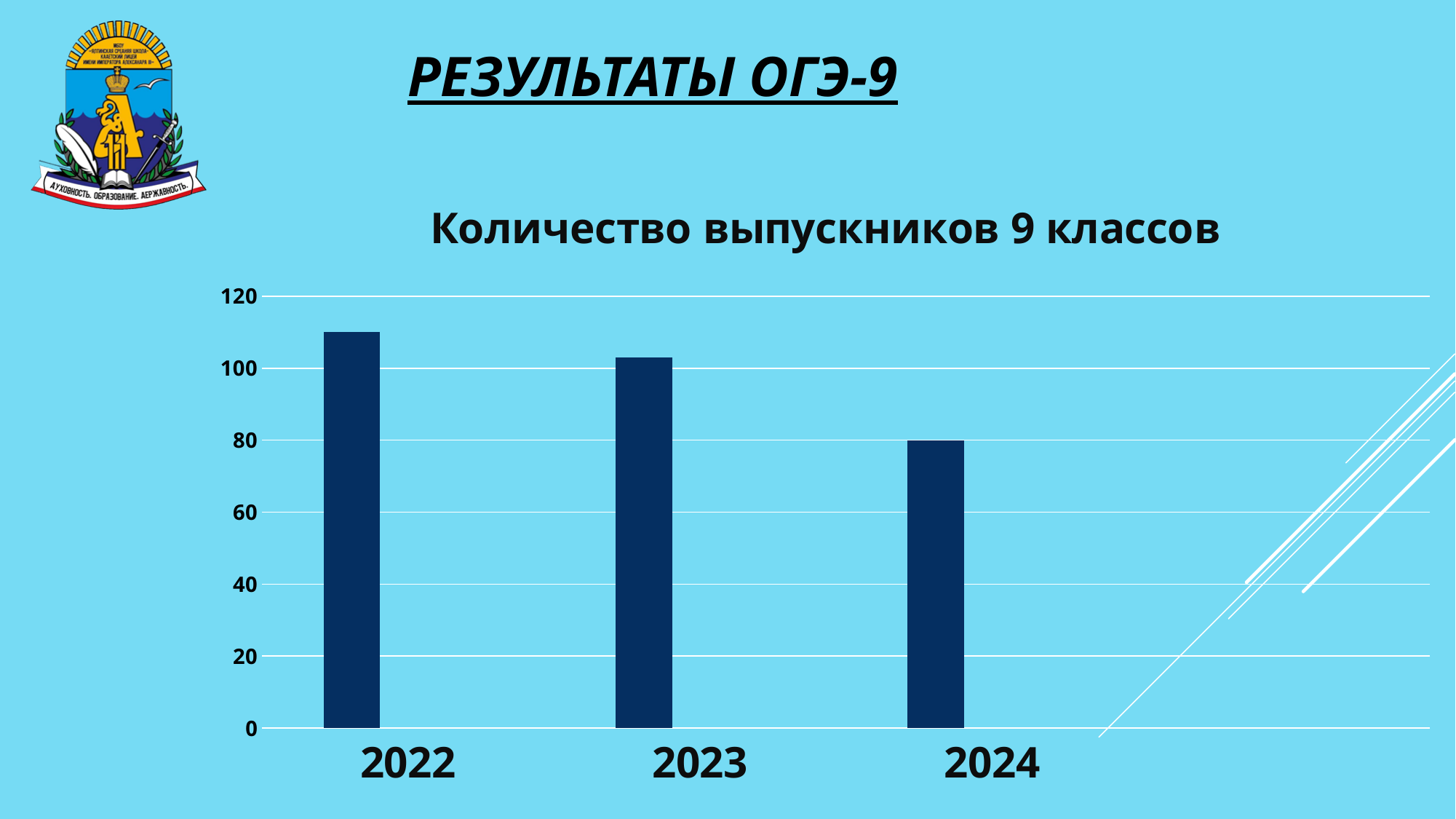
What is the title of the chart? Количество выпускников 9 классов How many years (categories) are shown on the x axis of the chart? 3 Which year has the highest number of 9th-grade graduates? 2022 What kind of chart is shown on the slide? bar chart Which year has the lowest number of 9th-grade graduates? 2024 Is the value for 2022 greater or less than 100? greater Do the values rise or fall from 2022 to 2024? fall Which year has more graduates, 2022 or 2024? 2022 Is the value for 2024 greater or less than 100? less Which year has more graduates, 2023 or 2024? 2023 Is the value for 2023 greater or less than 120? less What colour are the bars in the chart? dark blue